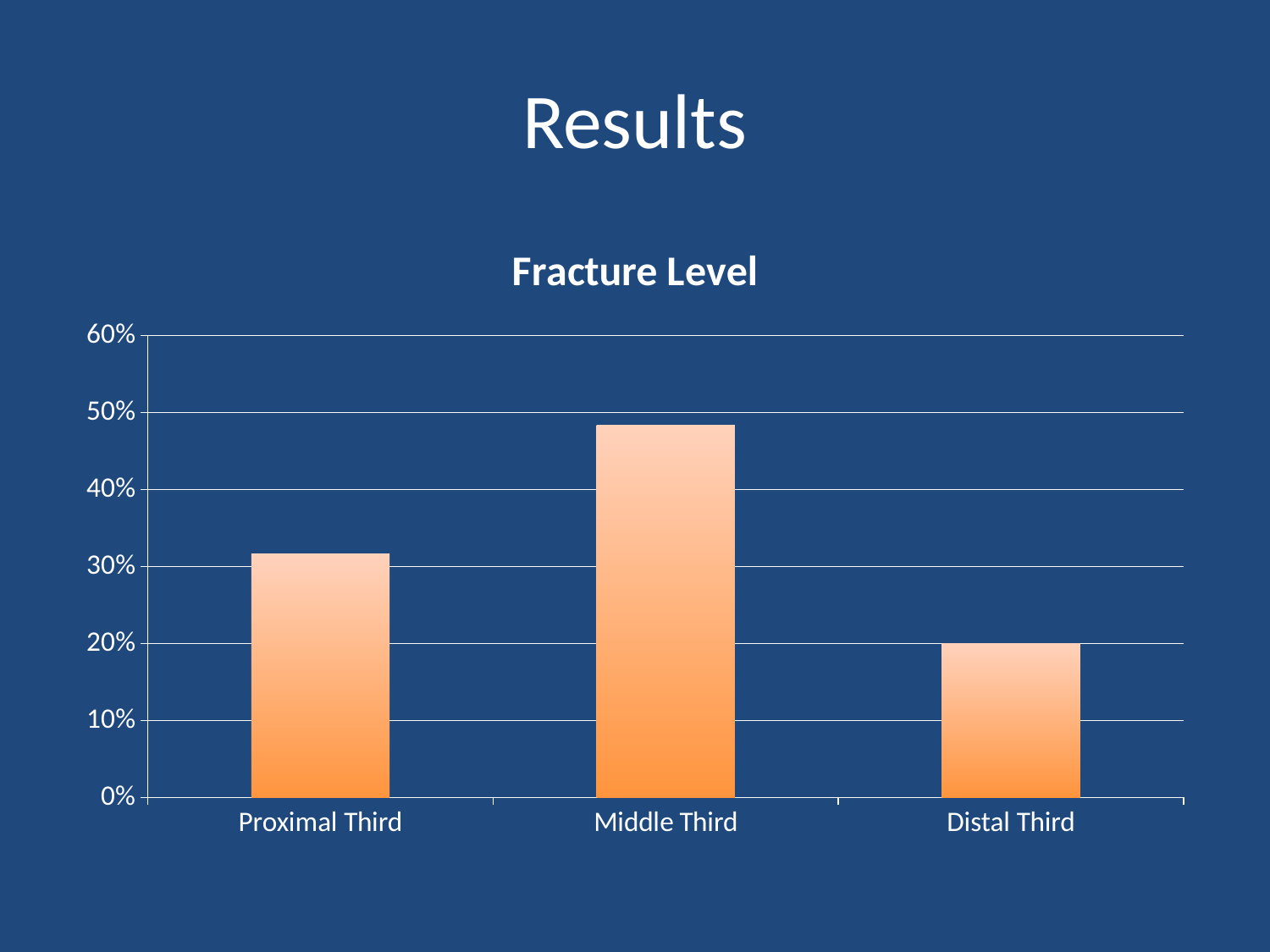
Which is larger, the value for Middle Third or the value for Proximal Third? Middle Third Which category has the highest value? Middle Third Is the value for Middle Third greater or less than 40%? greater Which category has the lowest value? Distal Third Does the value rise or fall from Middle Third to Distal Third? fall How many categories are shown on the x axis of the chart? 3 Is the value for Middle Third greater or less than 50%? less Which is larger, the value for Proximal Third or the value for Distal Third? Proximal Third What is the title of the chart? Fracture Level Is the value for Distal Third greater or less than 30%? less What kind of chart is shown on the slide? bar chart